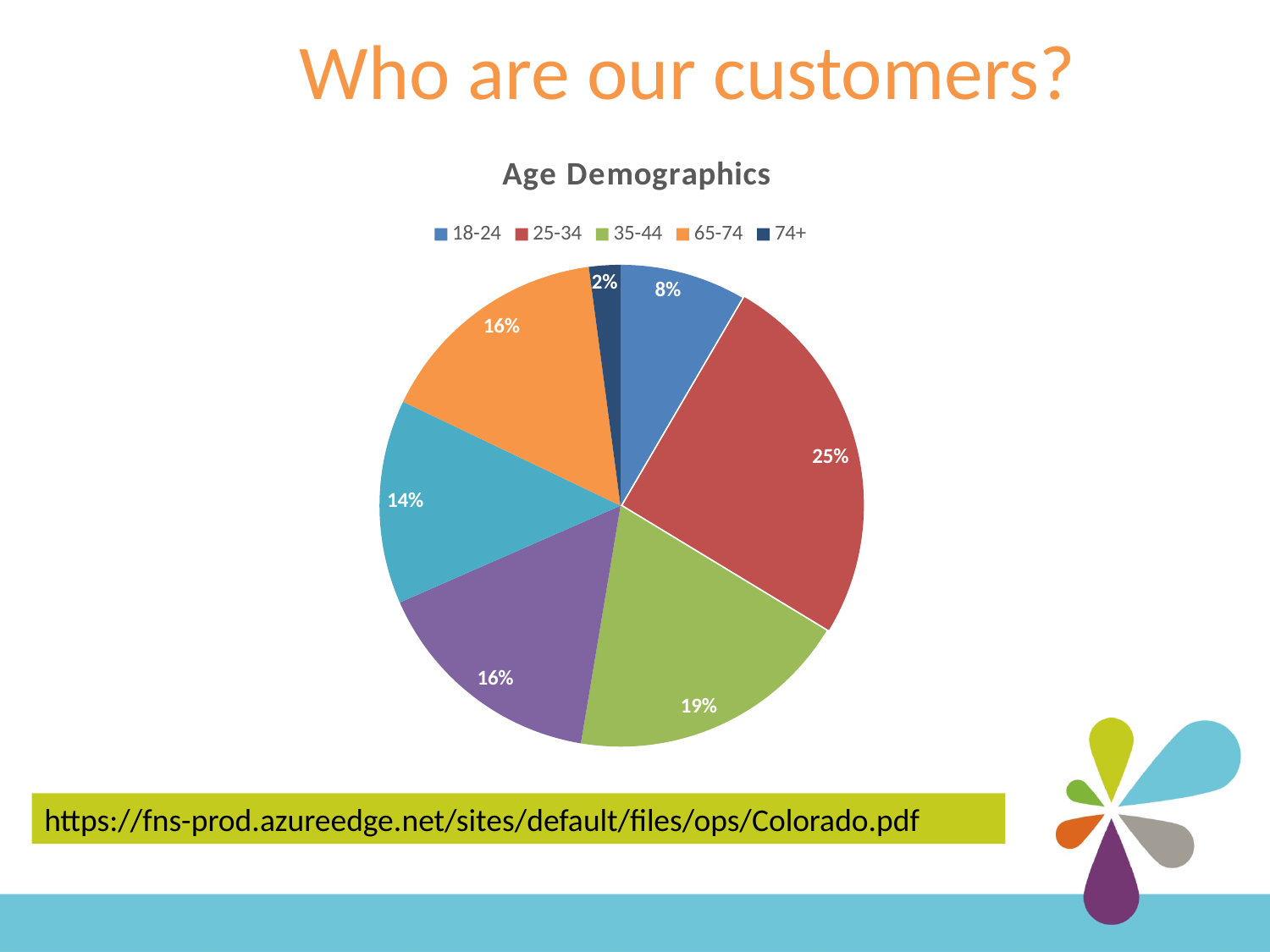
What percentage of customers are aged 74+? 2% What is the title of the chart? Age Demographics What percentage of customers are in the 65-74 age group? 16% Which age group has the smallest share of the pie? 74+ How many entries does the legend list? 5 What is the difference in percentage points between the 25-34 and 18-24 age groups? 17% What percentage of customers are in the 18-24 age group? 8% Which is larger, the share for 35-44 or the share for 65-74? 35-44 What percentage of customers are in the 35-44 age group? 19% What kind of chart is shown on the slide? pie chart What percentage of customers are in the 25-34 age group? 25% Which age group has the largest share of the pie? 25-34